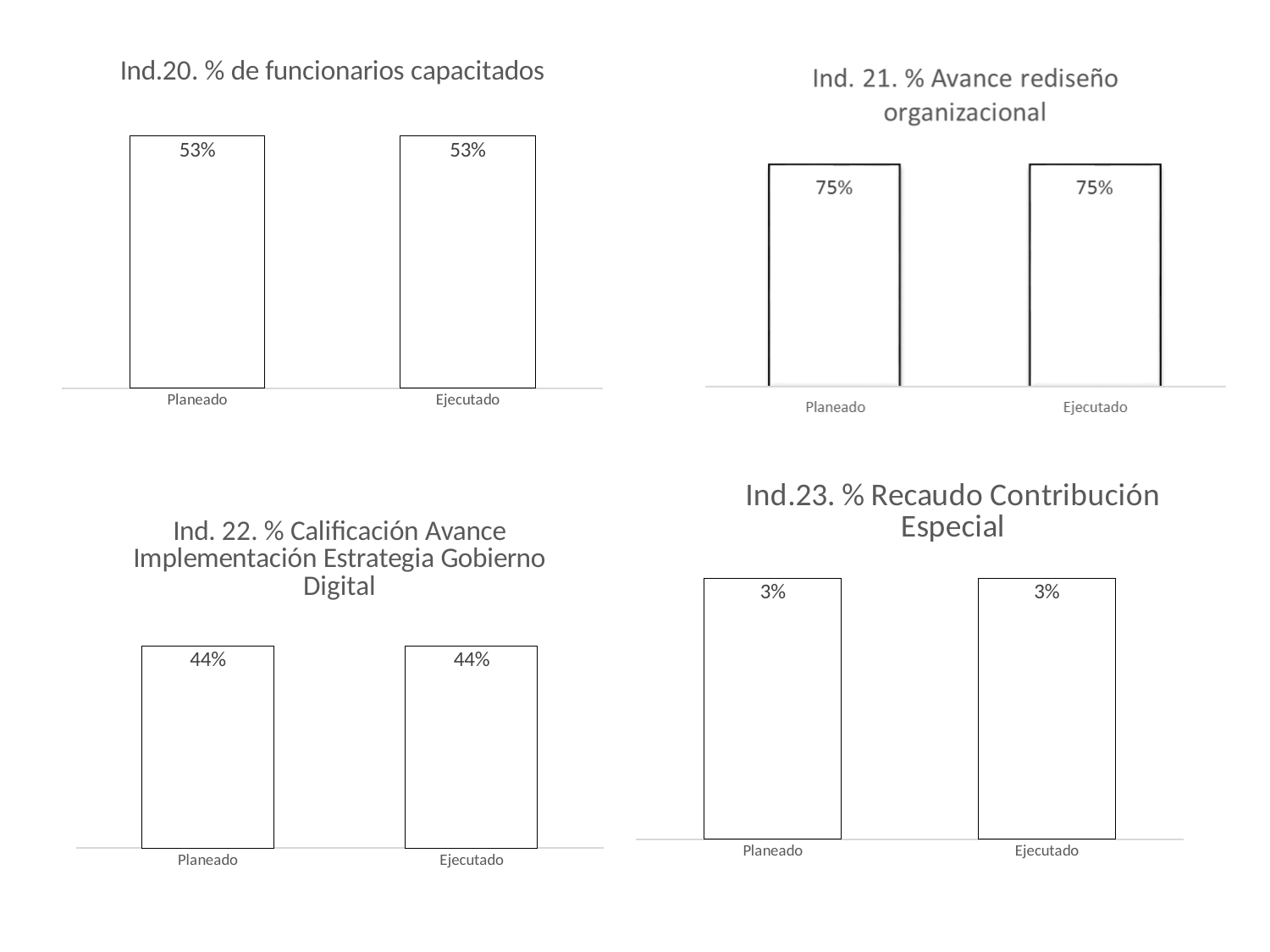
In the chart titled 'Ind. 21. % Avance rediseño organizacional', what is the difference between Planeado and Ejecutado? 0% In the chart titled 'Ind. 22. % Calificación Avance Implementación Estrategia Gobierno Digital', how many categories are shown on the x axis? 2 What are the two category labels on the x axis of the chart titled 'Ind.23. % Recaudo Contribución Especial'? Planeado and Ejecutado In the chart titled 'Ind. 21. % Avance rediseño organizacional', what is the value for Ejecutado? 75% In the chart titled 'Ind.20. % de funcionarios capacitados', what is the value for Ejecutado? 53% In the chart titled 'Ind.20. % de funcionarios capacitados', what is the difference between the Planeado and Ejecutado values? 0% How many charts are shown on the slide? 4 In the chart titled 'Ind.23. % Recaudo Contribución Especial', what is the value for Planeado? 3% In the chart titled 'Ind. 22. % Calificación Avance Implementación Estrategia Gobierno Digital', what is the value for Planeado? 44% In the chart titled 'Ind.23. % Recaudo Contribución Especial', what is the value for Ejecutado? 3% In the chart titled 'Ind.20. % de funcionarios capacitados', what is the value for Planeado? 53% What kind of chart is the one titled 'Ind.20. % de funcionarios capacitados'? Bar chart